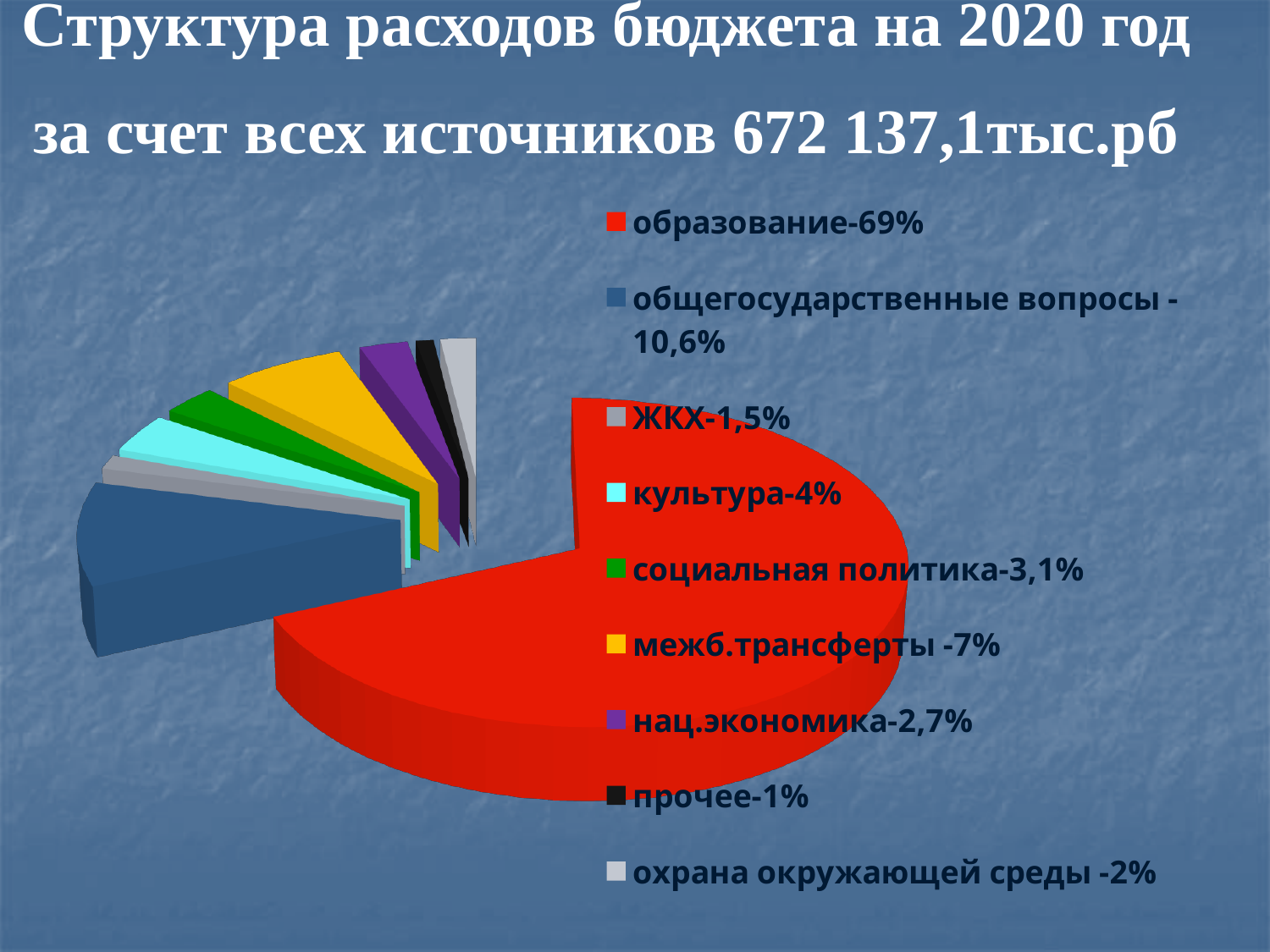
What kind of chart is shown on the slide? pie chart What share of the budget expenditure goes to образование? 69% What is the value for общегосударственные вопросы? 10,6% Which category has the smallest share of the pie? прочее What is the value for охрана окружающей среды? 2% What is the value for нац.экономика? 2,7% How many categories does the legend list? 9 What colour is the slice for образование? red What is the difference between the shares of образование and общегосударственные вопросы? 58,4% What is the value for межб.трансферты? 7% Which category has the largest share of the pie? образование Which is larger, the share for культура or the share for социальная политика? культура